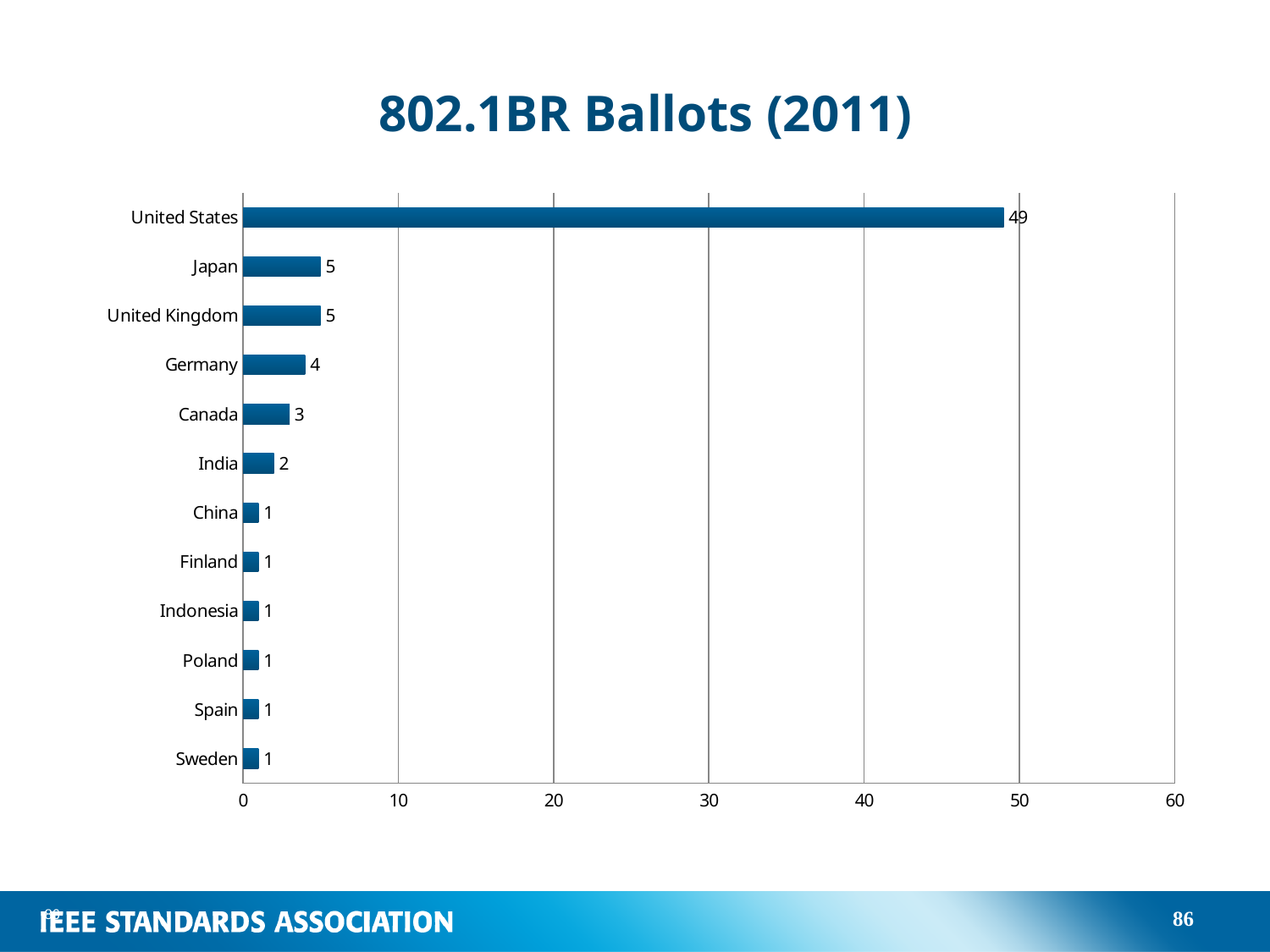
What is the value for Germany? 4 Which is larger, the value for Canada or the value for China? Canada What is the value for United States? 49 Is the value for United States greater or less than 40? greater What kind of chart is shown on the slide? bar chart How many countries are shown in the chart? 12 What is the difference between the values for United States and Japan? 44 What is the title of the chart? 802.1BR Ballots (2011) What is the difference between the values for Germany and India? 2 Which country has the highest value? United States What is the value for India? 2 What is the value for Canada? 3